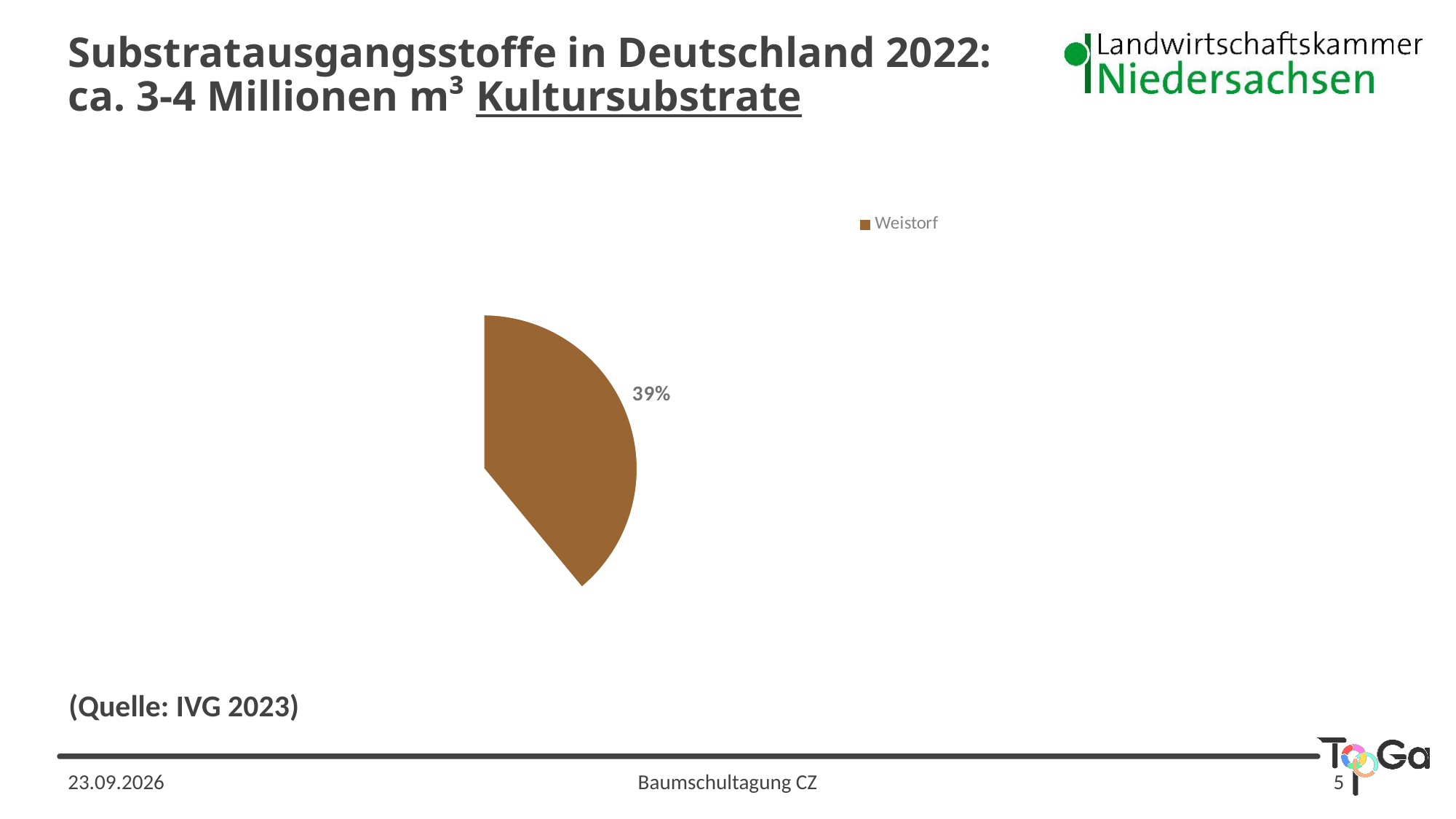
Is the share for Weistorf greater or less than 50%? less How many entries does the chart legend list? 1 What colour is the Weistorf slice of the pie chart? brown How many slices of the pie chart are labelled with a value? 1 What share of the pie does the Weistorf slice represent? 39% What is the data label printed on the Weistorf slice? 39% What kind of chart is shown on the slide? pie chart Which category is named in the chart legend? Weistorf Is the share for Weistorf greater or less than 30%? greater